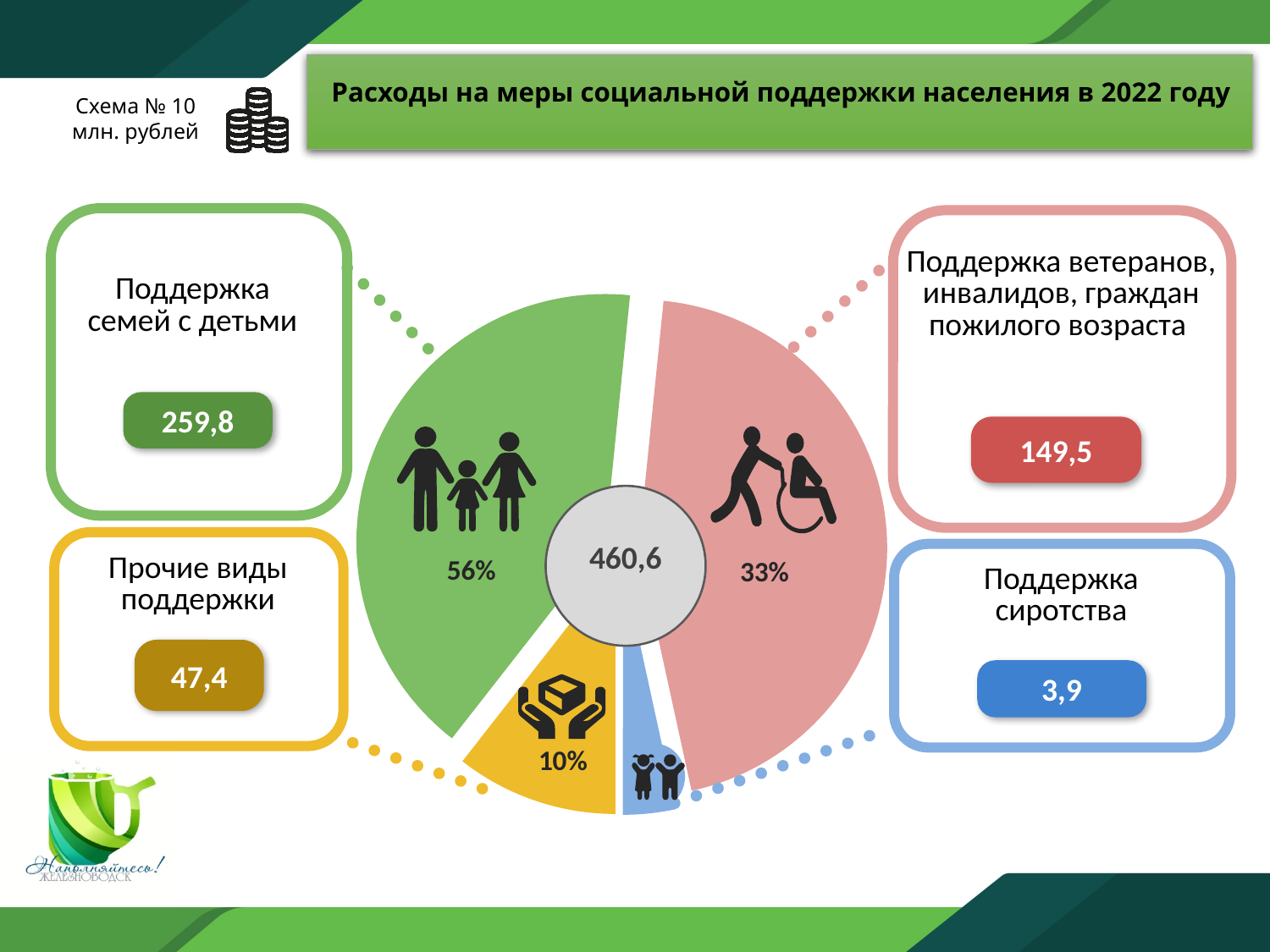
How many categories are shown in the chart? 4 What kind of chart is shown on the slide? Pie chart What share of the pie does Поддержка семей с детьми represent? 56% Which is larger: Прочие виды поддержки or Поддержка сиротства? Прочие виды поддержки What is the value for Поддержка семей с детьми? 259,8 Which category has the lowest value? Поддержка сиротства What share of the pie does Прочие виды поддержки represent? 10% What is the value for Прочие виды поддержки? 47,4 What is the difference between the values for Поддержка семей с детьми and Поддержка ветеранов, инвалидов, граждан пожилого возраста? 110,3 What is the value for Поддержка сиротства? 3,9 Which category has the highest value? Поддержка семей с детьми What is the value for Поддержка ветеранов, инвалидов, граждан пожилого возраста? 149,5